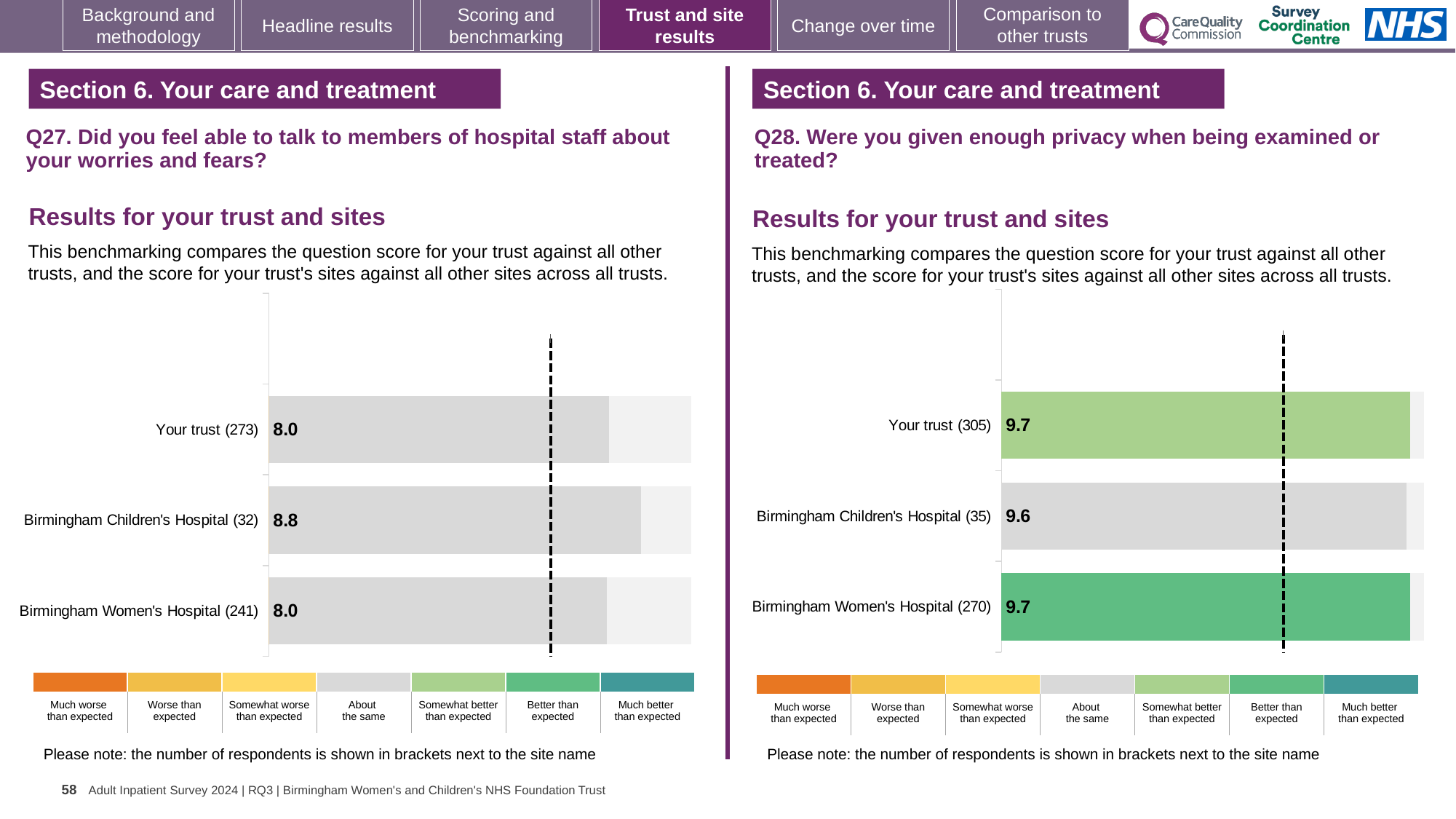
In the Q28 chart on the right, what is the score for Your trust? 9.7 In the Q27 chart on the left, what is the score for Your trust? 8.0 In the Q27 chart on the left, what is the difference between the scores for Birmingham Children's Hospital and Birmingham Women's Hospital? 0.8 In the Q27 chart on the left, which site or trust has the highest score? Birmingham Children's Hospital How many bars are plotted in the Q27 chart on the left? 3 In the Q28 chart on the right, which site has the lowest score? Birmingham Children's Hospital What kind of chart is used in the Q28 chart on the right? Bar chart In the Q28 chart on the right, what is the score for Birmingham Children's Hospital? 9.6 In the Q27 chart on the left, what is the score for Birmingham Children's Hospital? 8.8 In the Q28 chart on the right, what is the score for Birmingham Women's Hospital? 9.7 In the Q27 chart on the left, what is the score for Birmingham Women's Hospital? 8.0 In the Q28 chart on the right, how many respondents are shown in brackets for Birmingham Women's Hospital? 270